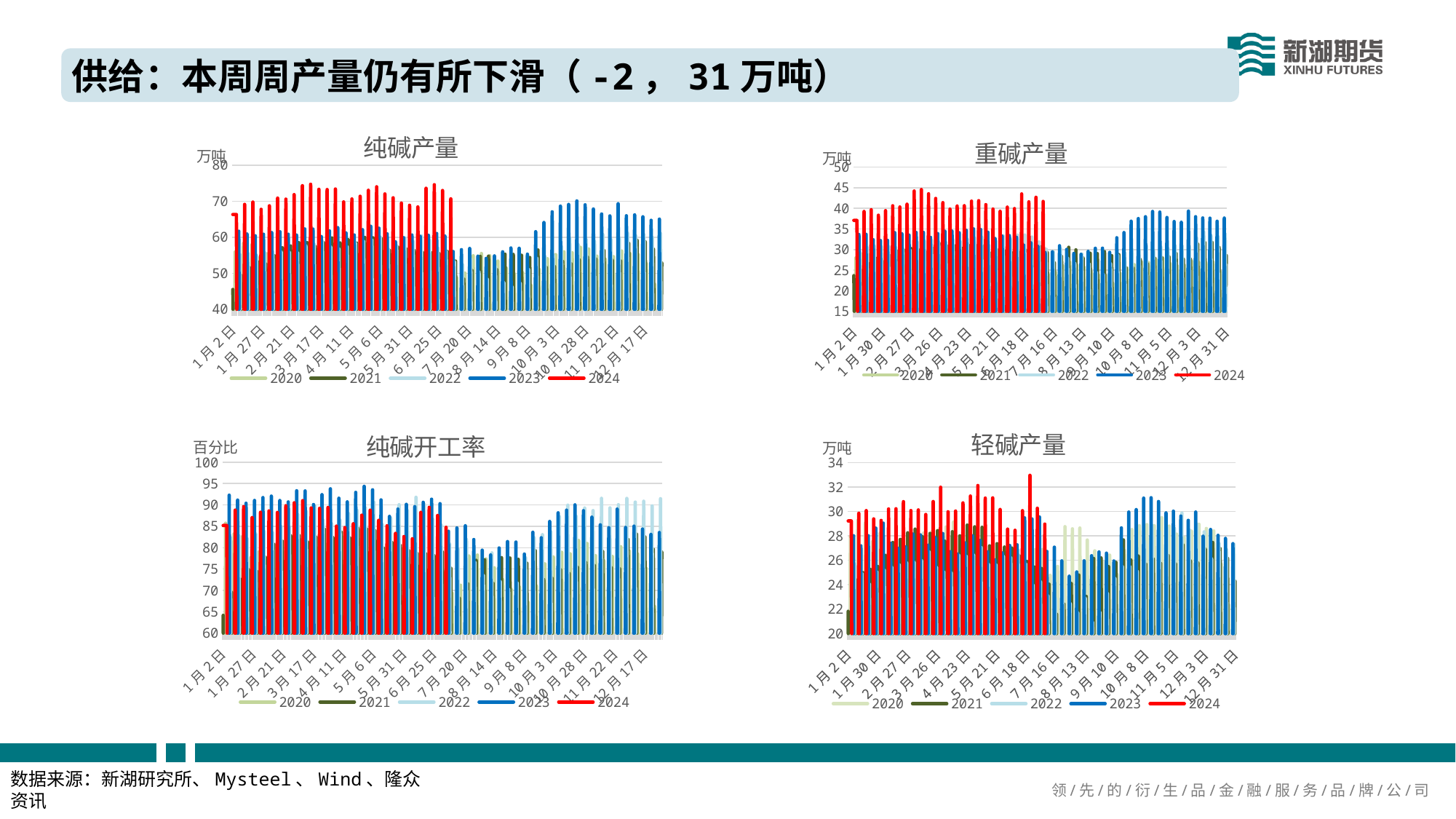
In the 纯碱产量 chart, is the 2024 value at 1月2日 greater or less than 60? greater What kind of chart is the 纯碱开工率 chart? bar chart What kind of chart is the 重碱产量 chart? bar chart What unit is shown on the y axis of the 轻碱产量 chart? 万吨 In the 轻碱产量 chart, is the highest 2024 value greater or less than 30? greater In the 重碱产量 chart, is the 2021 value at 1月2日 greater or less than 30? less How many series does the legend of the 纯碱产量 chart list? 5 Which series is drawn in red in the 纯碱开工率 chart? 2024 How many series does the legend of the 轻碱产量 chart list? 5